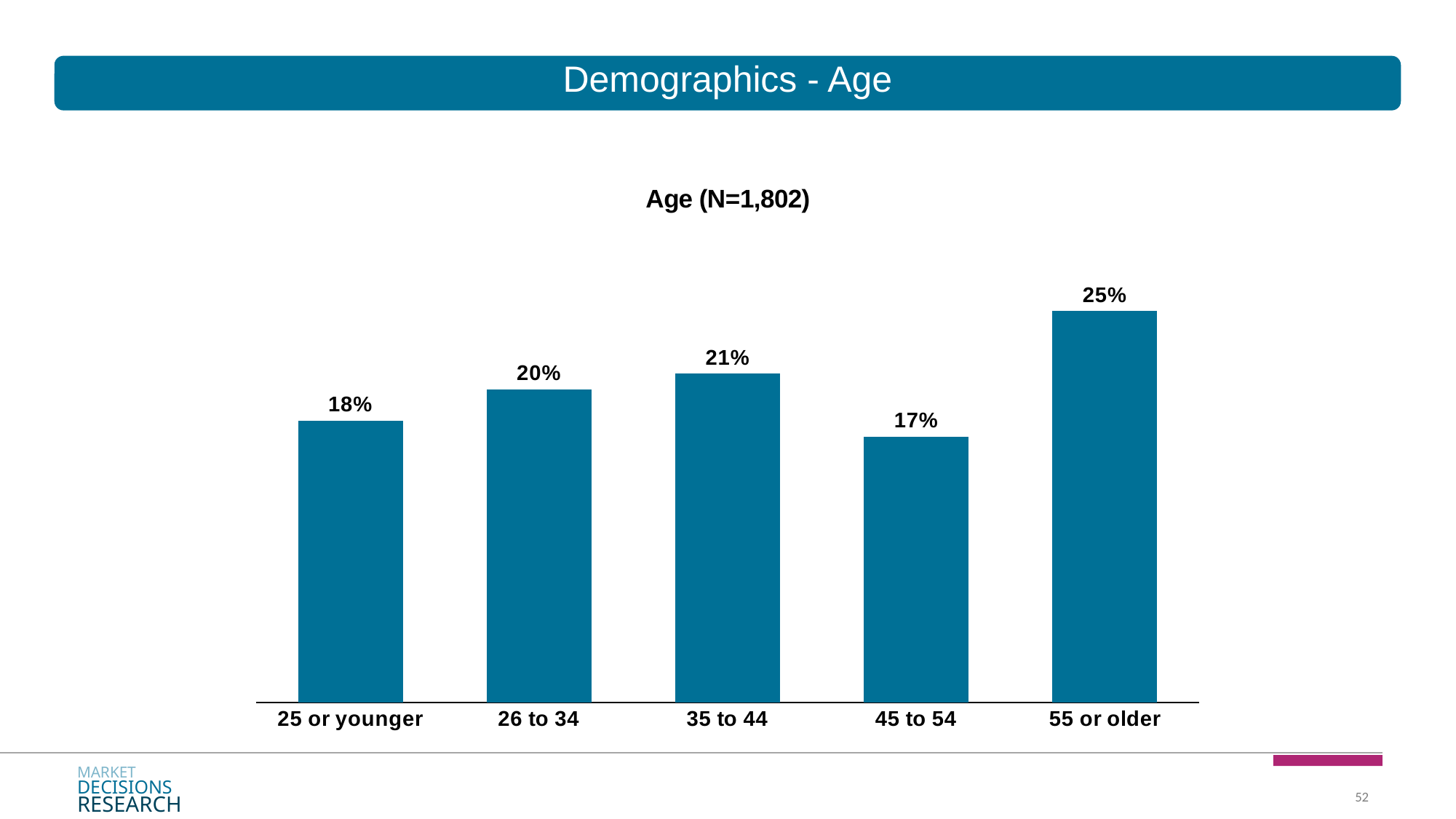
What is the title of the chart? Age (N=1,802) What is the sample size (N) shown in the chart title? 1,802 What percentage of respondents are 25 or younger? 18% What is the difference between the 35 to 44 and 25 or younger age groups? 3% What kind of chart is shown on the slide? Bar chart Which age group has the lowest percentage? 45 to 54 What is the difference between the 55 or older and 45 to 54 age groups? 8% How many age categories are shown in the chart? 5 What is the value for the 45 to 54 age group? 17% What is the value for the 55 or older age group? 25% Which age group has the highest percentage? 55 or older Which is larger, the value for 26 to 34 or the value for 45 to 54? 26 to 34